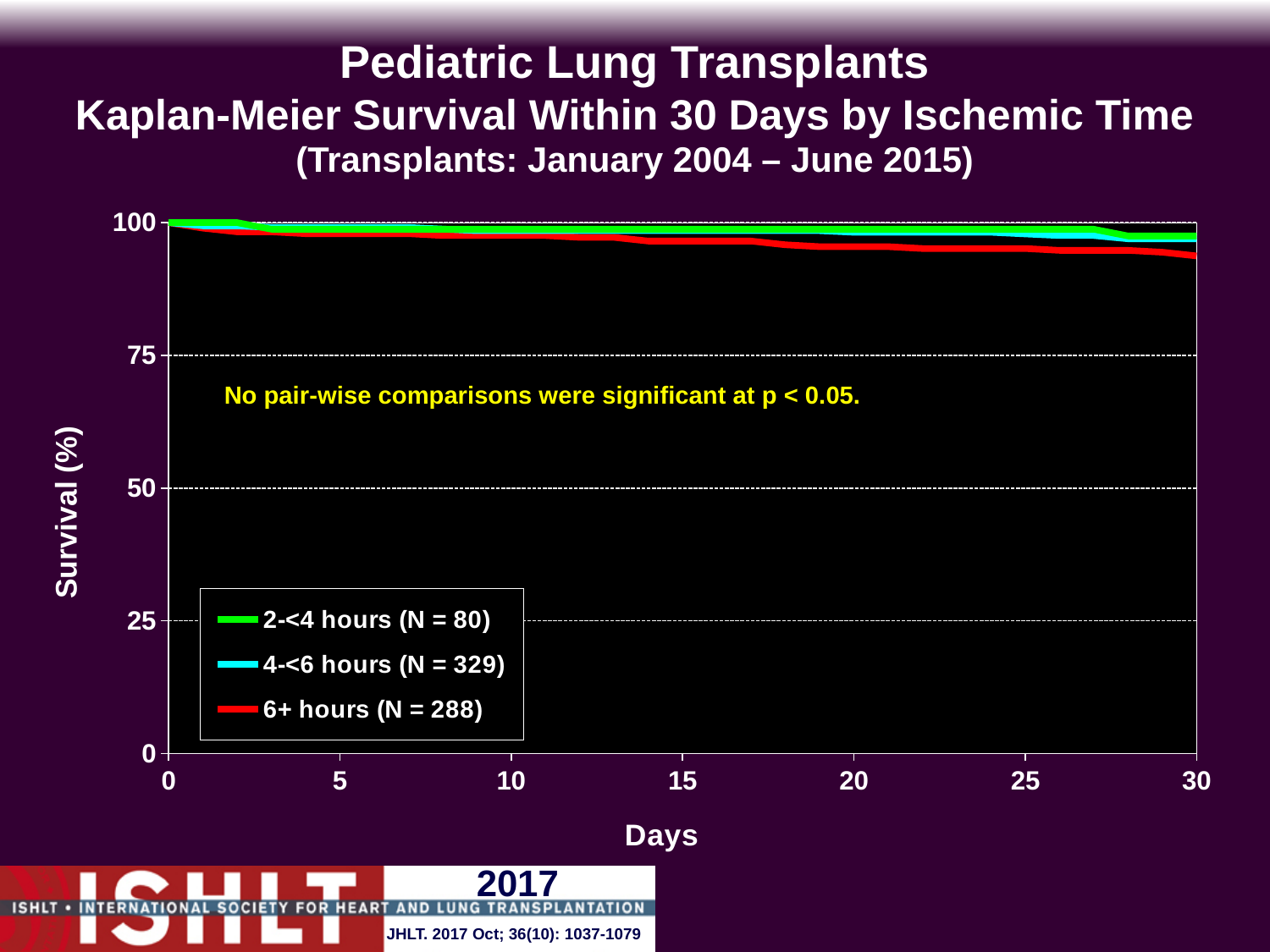
Which ischemic time group has the lowest survival at day 30? 6+ hours Do the survival curves rise or fall as days increase? fall At day 30, is survival for the 2-<4 hours group higher or lower than for the 6+ hours group? higher Is the survival value for the 6+ hours group at day 30 greater or less than 75? greater What is the N for the 2-<4 hours group? 80 Which colour represents the 4-<6 hours group? cyan What is the N for the 6+ hours group? 288 What is the label of the y axis? Survival (%) What kind of chart is shown on the slide? line chart What is the survival value for all groups at day 0? 100 How many series does the legend list? 3 What is the N for the 4-<6 hours group? 329